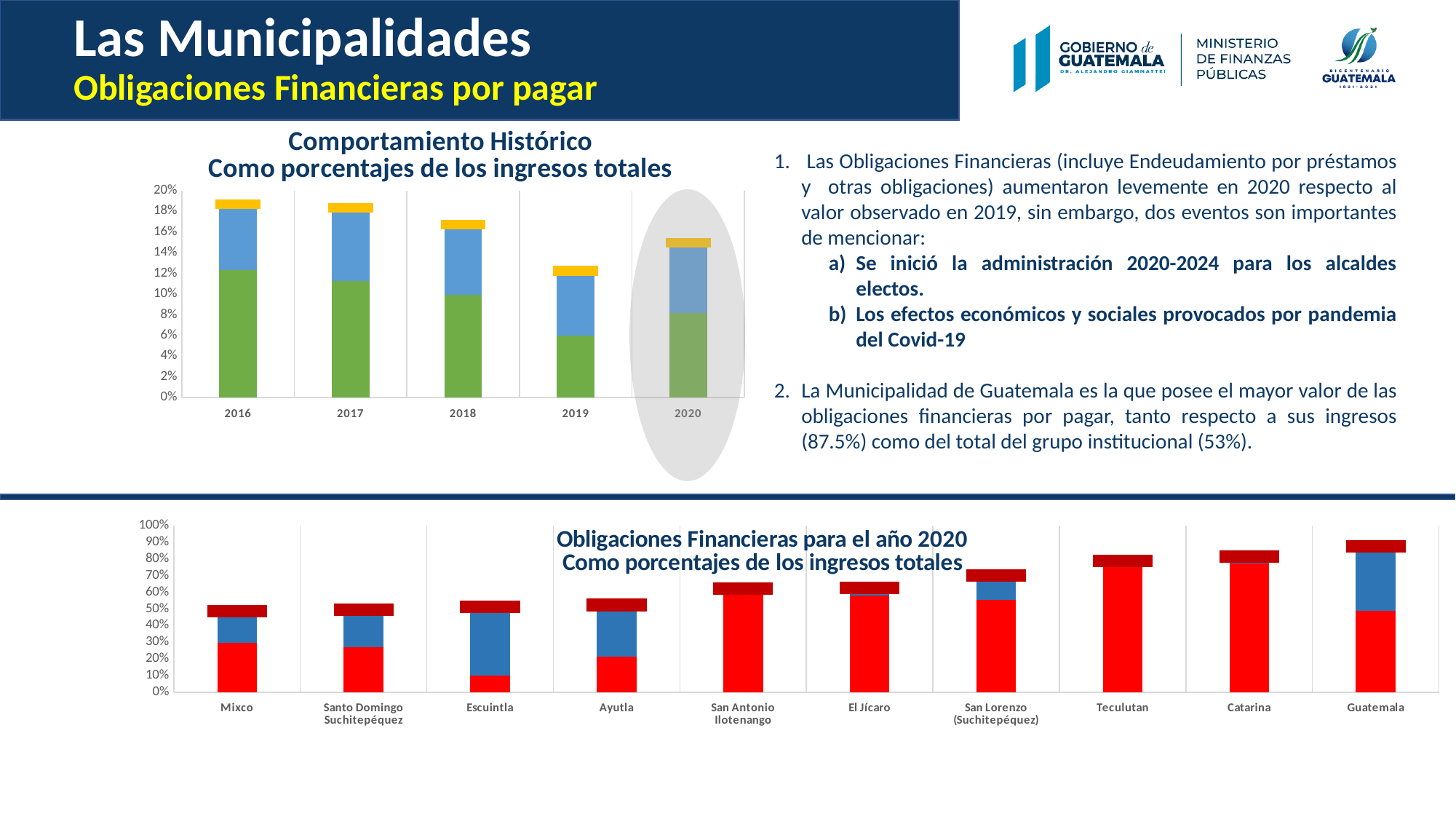
In the top chart 'Comportamiento Histórico', which year has the highest total bar? 2016 In the bottom chart 'Obligaciones Financieras para el año 2020', is the total value for Guatemala greater or less than 80%? greater In the bottom chart 'Obligaciones Financieras para el año 2020', which has the larger total bar, Teculutan or Escuintla? Teculutan What kind of chart is the top chart titled 'Comportamiento Histórico'? Stacked bar chart How many municipalities are shown on the x axis of the bottom chart 'Obligaciones Financieras para el año 2020'? 10 In the top chart 'Comportamiento Histórico', which year has the lowest total bar? 2019 How many years are shown on the x axis of the top chart 'Comportamiento Histórico'? 5 What is the title of the bottom chart? Obligaciones Financieras para el año 2020 Como porcentajes de los ingresos totales In the bottom chart 'Obligaciones Financieras para el año 2020', which municipality has the highest total bar? Guatemala In the top chart 'Comportamiento Histórico', do the total bar heights rise or fall from 2016 to 2019? Fall In the top chart 'Comportamiento Histórico', is the total value for 2016 greater or less than 18%? greater In the top chart 'Comportamiento Histórico', is the total value for 2019 greater or less than 14%? less